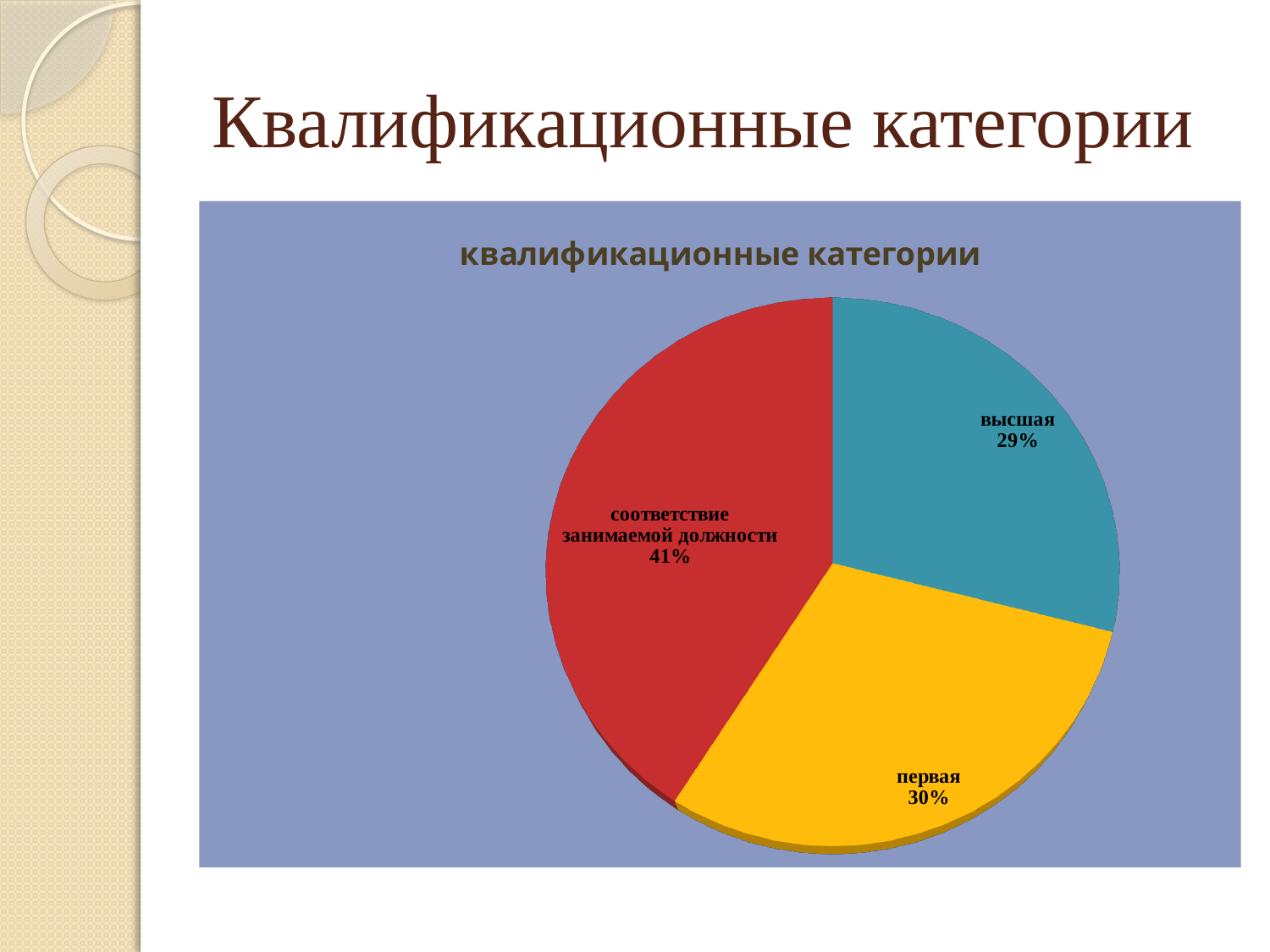
What share of the pie is labelled "высшая"? 29% What share of the pie is labelled "соответствие занимаемой должности"? 41% Which category has the smallest share of the pie? высшая How many slices does the pie chart have? 3 What share of the pie is labelled "первая"? 30% What is the difference in percentage points between "первая" and "высшая"? 1 Which category has the largest share of the pie? соответствие занимаемой должности What colour is the slice labelled "первая"? yellow What is the difference in percentage points between "соответствие занимаемой должности" and "высшая"? 12 Which is larger: the share for "соответствие занимаемой должности" or the share for "первая"? соответствие занимаемой должности What is the chart's title? квалификационные категории What type of chart is shown on the slide? pie chart